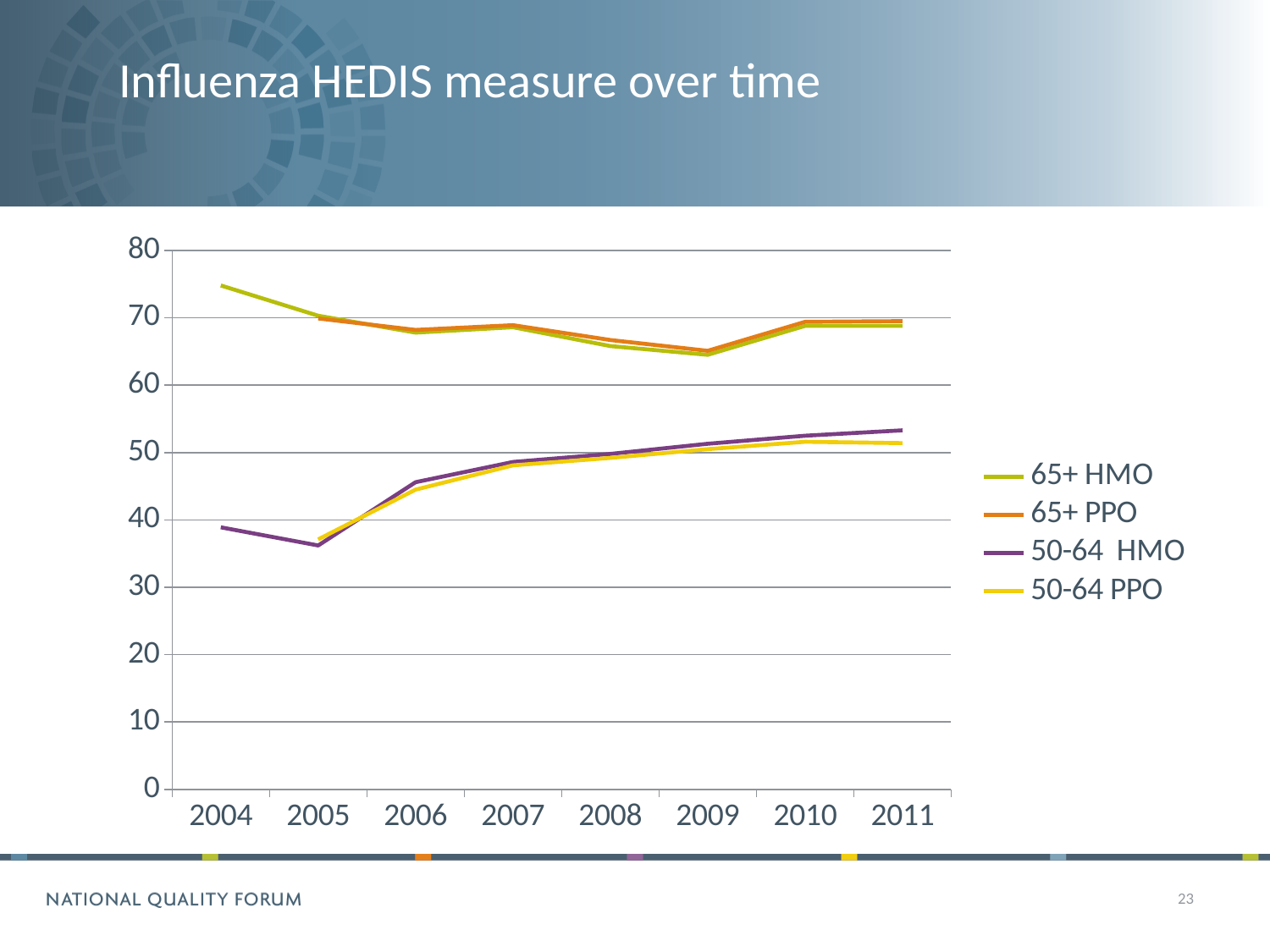
In which year is the 65+ HMO value highest? 2004 Does the 65+ HMO line rise or fall from 2004 to 2009? fall Is the value for 50-64 HMO in 2005 greater or less than 40? less Is the value for 65+ PPO in 2009 greater or less than 70? less Does the 50-64 HMO line rise or fall from 2005 to 2011? rise In 2004, which is larger: the value for 65+ HMO or the value for 50-64 HMO? 65+ HMO Is the value for 65+ HMO in 2004 greater or less than 70? greater What kind of chart is shown on the slide? line chart How many series does the legend list? 4 How many years are shown on the x axis? 8 What is the title of the chart? Influenza HEDIS measure over time